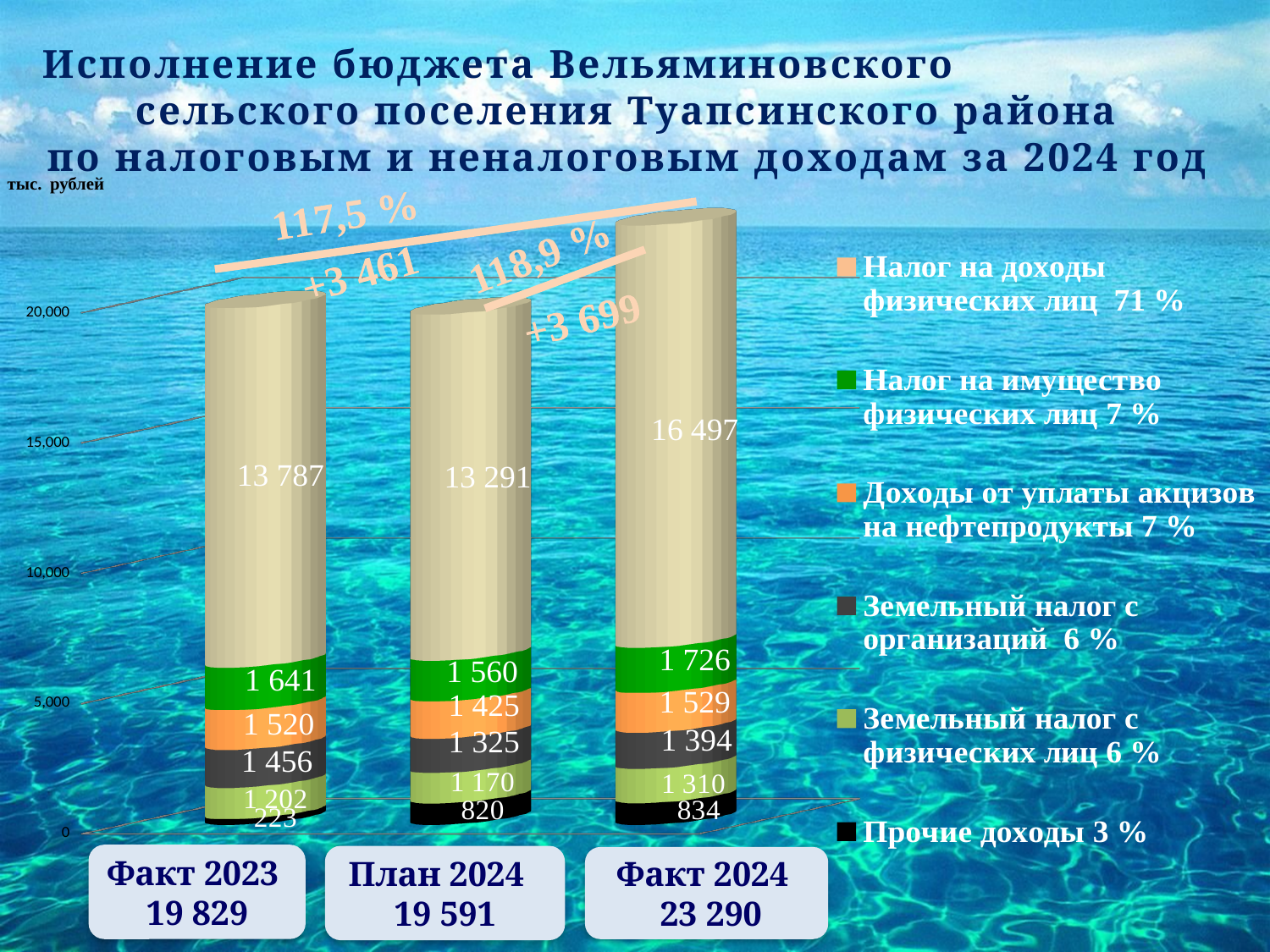
What is the value of Земельный налог с организаций for Факт 2024? 1 394 How many series does the legend list? 6 What is the difference between Налог на доходы физических лиц for Факт 2024 and Факт 2023? 2 710 How many bars (categories) are shown on the chart? 3 Which bar has the lowest value for Прочие доходы? Факт 2023 Which bar has the highest value for Налог на доходы физических лиц? Факт 2024 Which is larger: Доходы от уплаты акцизов на нефтепродукты for Факт 2023 or for План 2024? Факт 2023 What is the value of Налог на доходы физических лиц for Факт 2024? 16 497 What is the value of Прочие доходы for Факт 2023? 223 What is the value of Налог на имущество физических лиц for План 2024? 1 560 What is the total of the Факт 2024 stacked bar? 23 290 What kind of chart is shown on the slide? Stacked bar chart